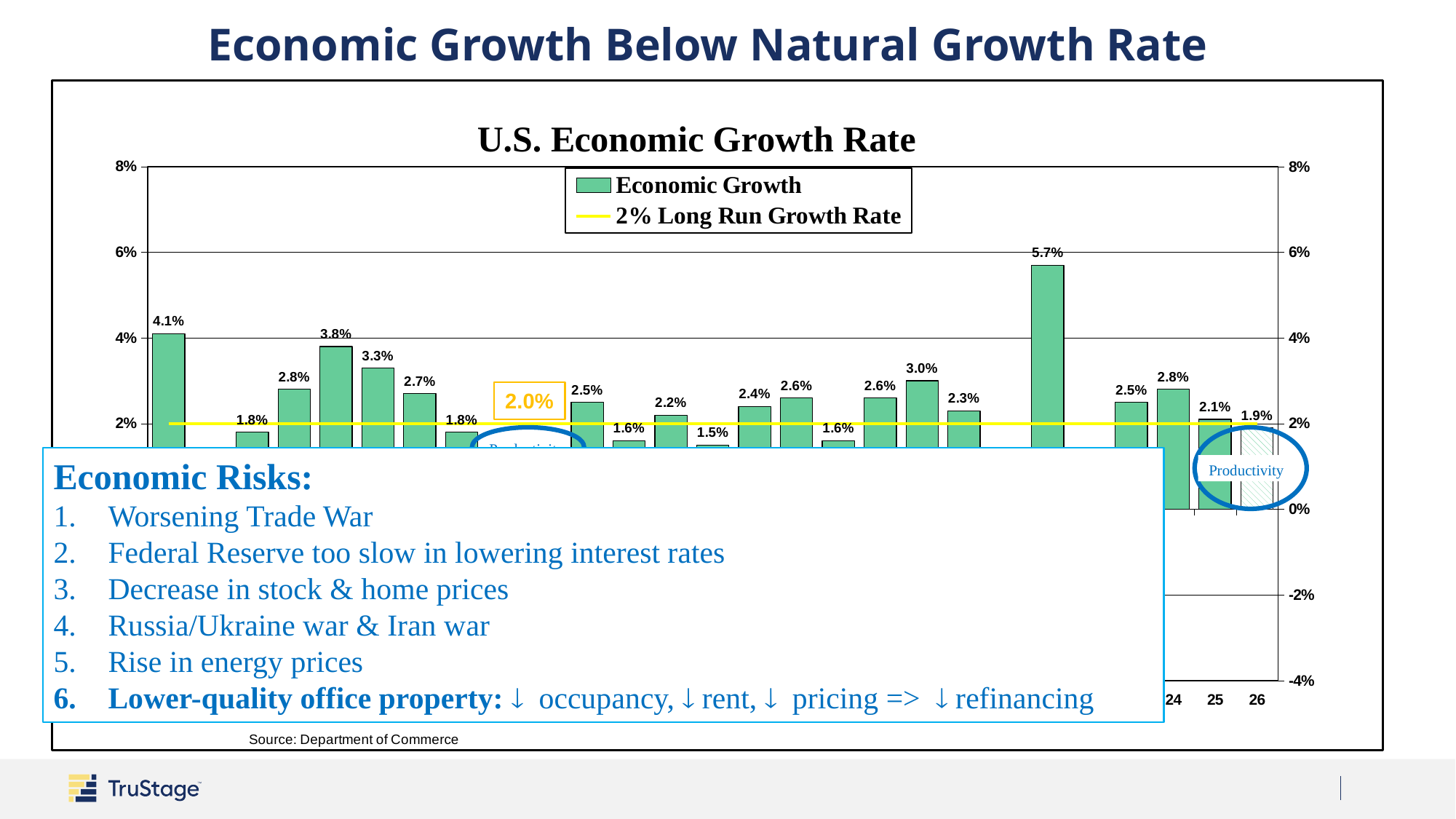
Do the economic growth rates rise or fall from 24 to 26? Fall What is the value of the long run growth rate line shown on the chart? 2.0% How many series does the chart legend list? 2 What is the title of the chart? U.S. Economic Growth Rate What is the economic growth rate shown for 25? 2.1% What source is cited for the chart data? Department of Commerce Which year has the larger economic growth rate, 25 or 26? 25 What type of chart is used to show the U.S. Economic Growth Rate? Bar chart What is the economic growth rate shown for 26? 1.9% What is the difference between the economic growth rate for 24 and for 25? 0.7% What is the highest economic growth rate labelled on the chart? 5.7% What is the economic growth rate shown for 24? 2.8%